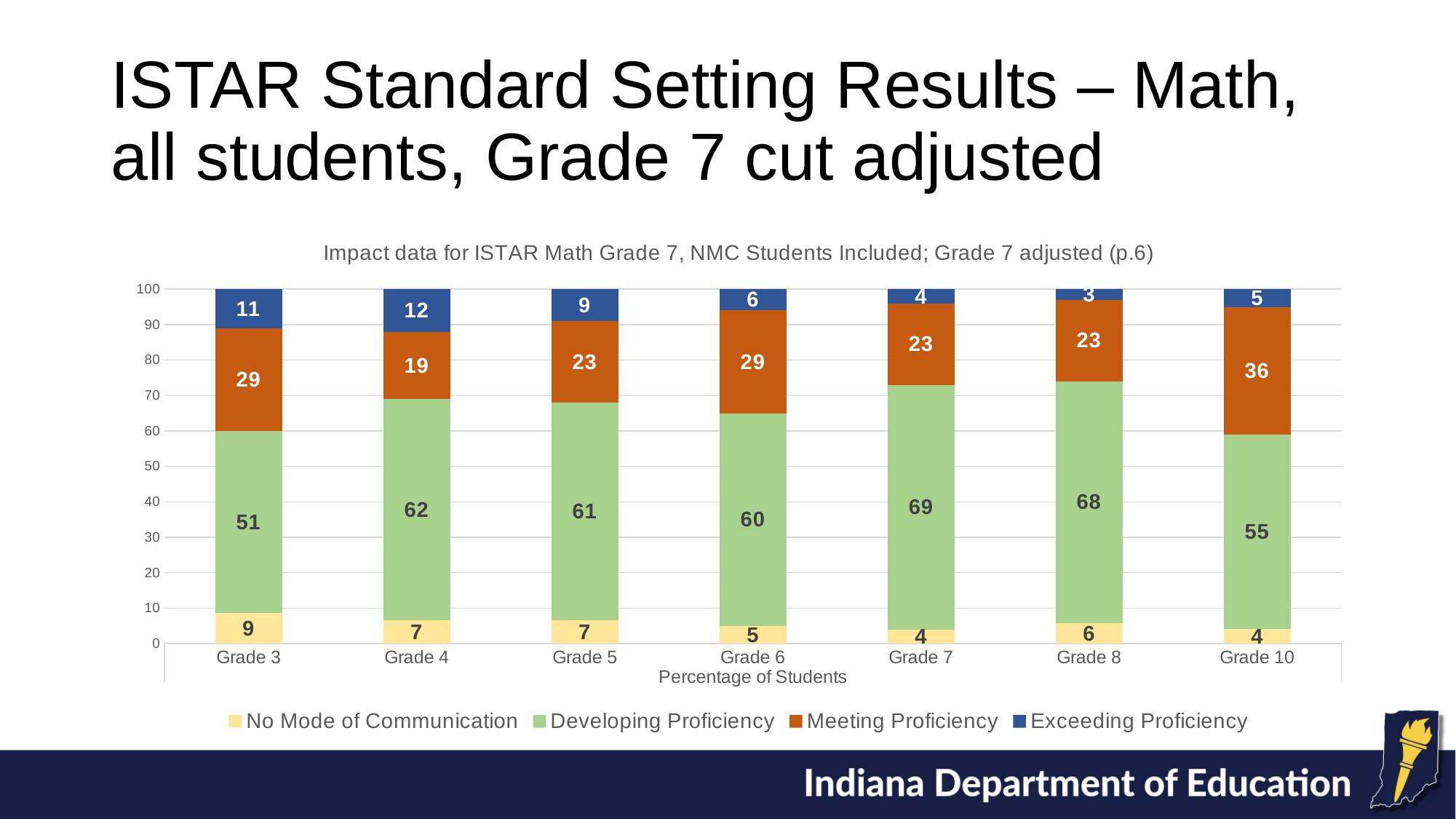
What kind of chart is shown on the slide? Stacked bar chart Which grade has the lowest Exceeding Proficiency value? Grade 8 Which has the larger Developing Proficiency value, Grade 7 or Grade 8? Grade 7 What is the total of the stacked bar for Grade 3? 100 How many grade categories are shown on the x axis? 7 What is the Developing Proficiency value for Grade 4? 62 What is the Meeting Proficiency value for Grade 10? 36 What is the difference between the Meeting Proficiency values for Grade 3 and Grade 4? 10 How many series does the legend list? 4 What is the No Mode of Communication value for Grade 3? 9 Which grade has the highest Meeting Proficiency value? Grade 10 Which grade has the highest Exceeding Proficiency value? Grade 4